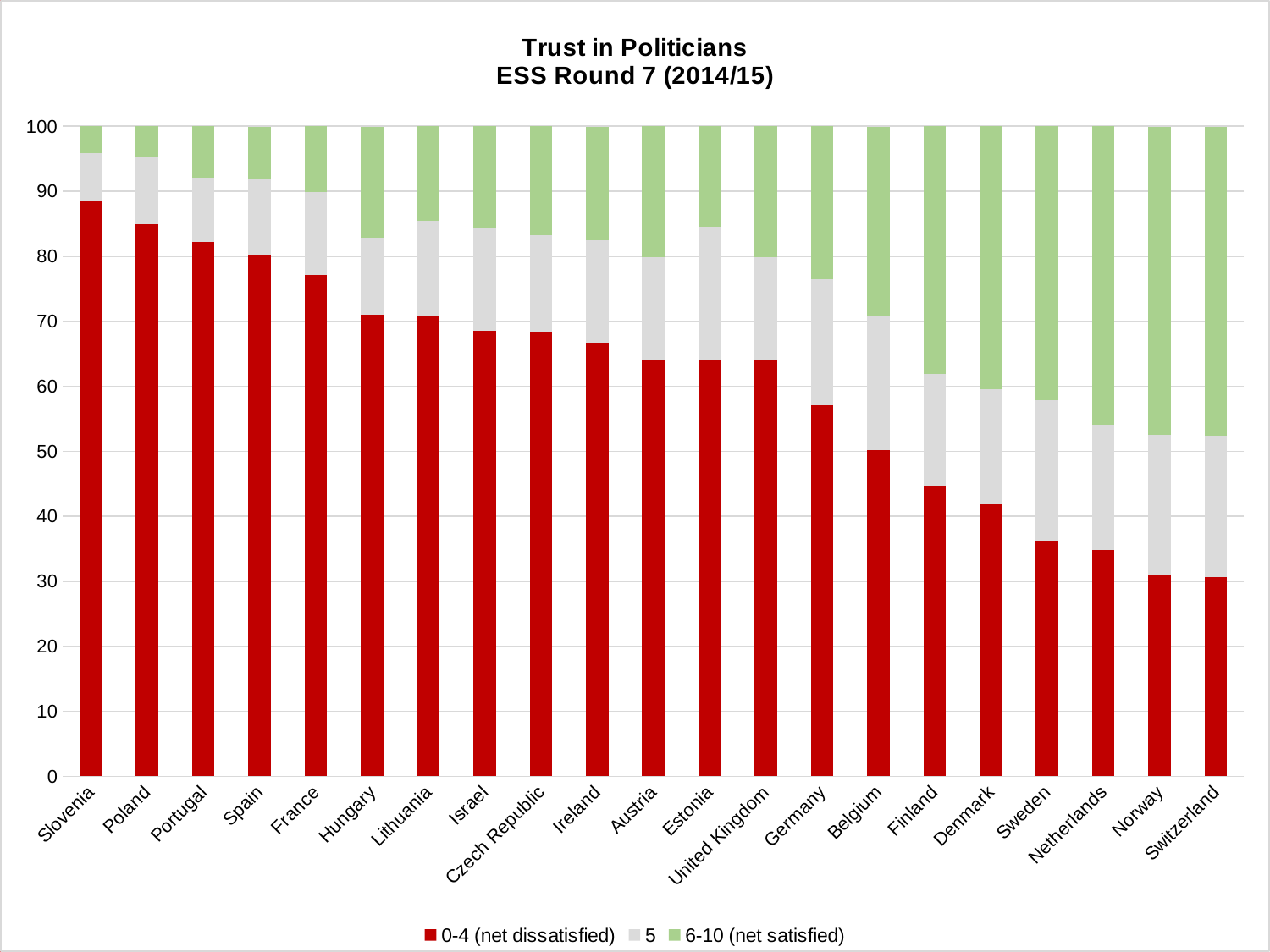
Which country has the highest value for the 0-4 (net dissatisfied) series? Slovenia How many countries are shown on the x axis of the chart? 21 What kind of chart is shown on the slide? stacked bar chart Is the 0-4 (net dissatisfied) value for Finland greater or less than 50? less Do the 0-4 (net dissatisfied) values rise or fall moving from left to right along the x axis? fall Which has the larger 0-4 (net dissatisfied) value, Poland or Germany? Poland How many series does the legend list? 3 Is the 0-4 (net dissatisfied) value for Sweden greater or less than 40? less What is the title of the chart? Trust in Politicians ESS Round 7 (2014/15) Is the 0-4 (net dissatisfied) value for Slovenia greater or less than 80? greater